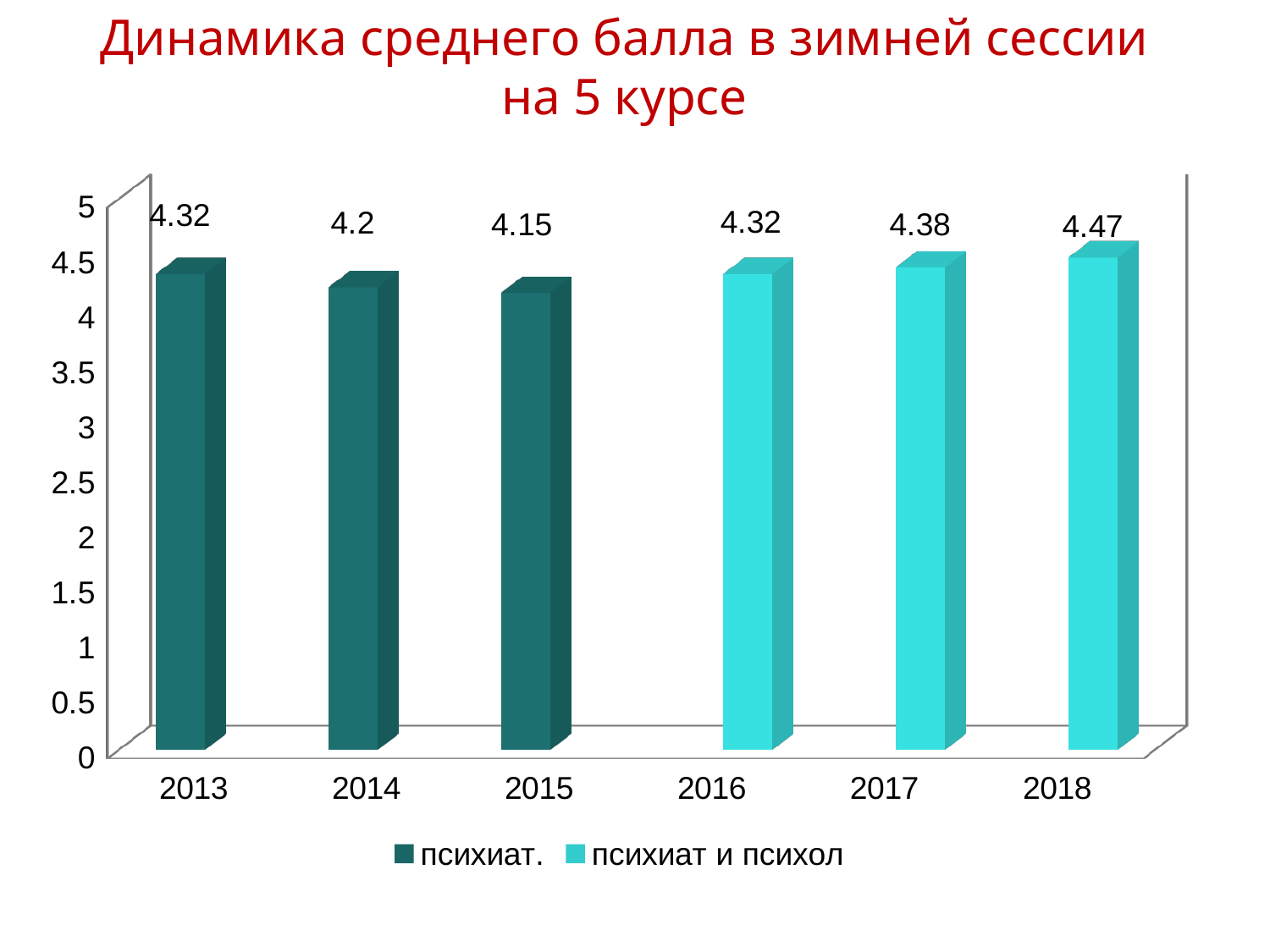
What is the value for 2015? 4.15 Which is larger, the value for 2014 or the value for 2017? 2017 How many years are shown on the x axis? 6 What is the value for 2018? 4.47 Which year has the lowest value? 2015 Which year has the highest value? 2018 Do the values rise or fall from 2016 to 2018? rise What is the difference between the values for 2018 and 2015? 0.32 What is the value for 2013? 4.32 What kind of chart is shown? bar chart How many series does the legend list? 2 Is the value for 2016 greater or less than 4? greater